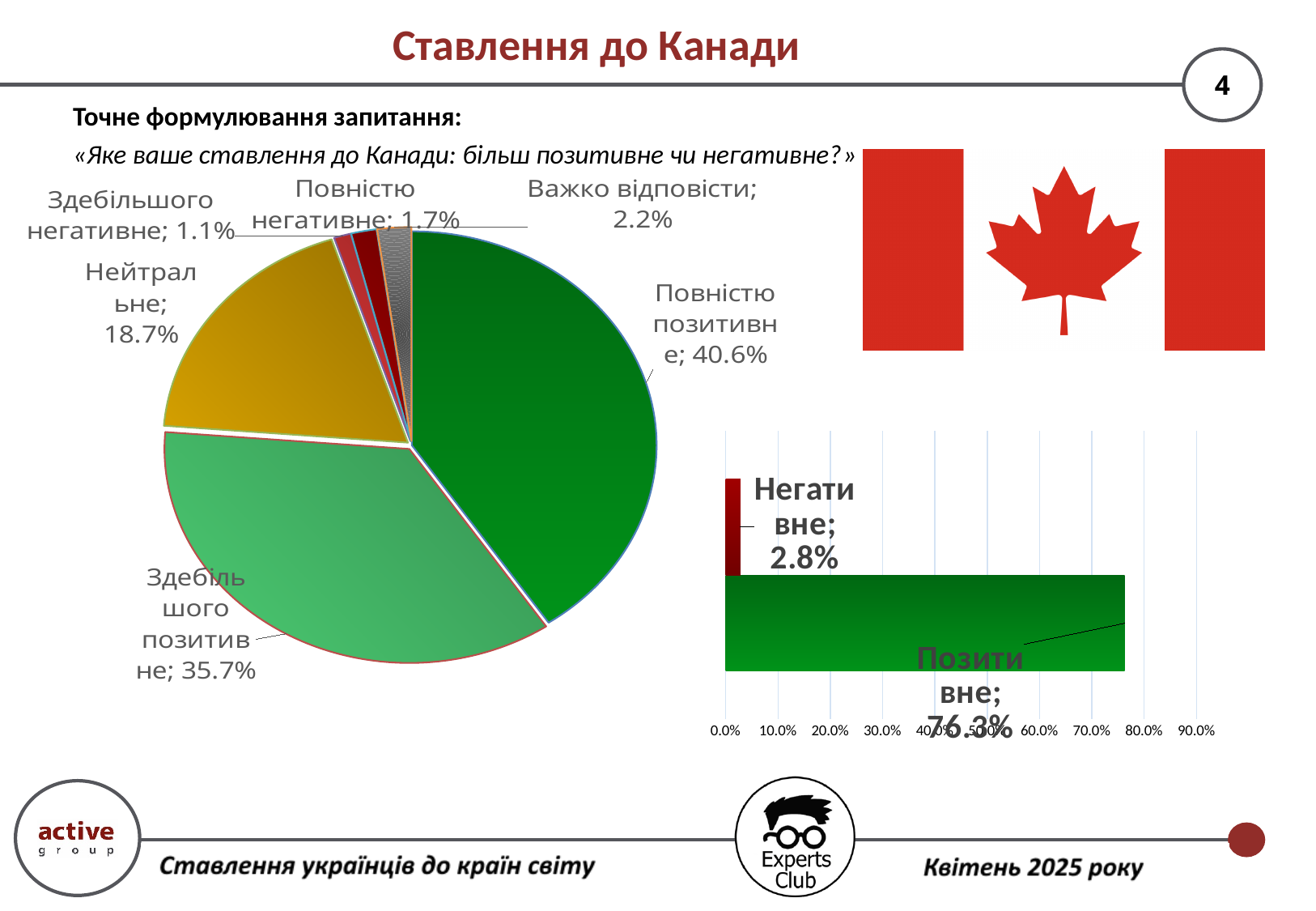
What type of chart is shown on the right side of the slide? Bar chart How many slices does the pie chart on the left have? 6 In the pie chart on the left, what is the difference between "Повністю позитивне" and "Здебільшого позитивне"? 4.9% In the bar chart on the right, what is the value for "Позитивне"? 76.3% In the bar chart on the right, what is the value for "Негативне"? 2.8% In the pie chart on the left, what is the value for "Важко відповісти"? 2.2% In the pie chart on the left, which category has the largest share? Повністю позитивне In the bar chart on the right, what is the difference between "Позитивне" and "Негативне"? 73.5% In the pie chart on the left, what is the value for "Повністю позитивне"? 40.6% In the pie chart on the left, what is the value for "Нейтральне"? 18.7% In the pie chart on the left, which category has the smallest share? Здебільшого негативне In the pie chart on the left, which is larger: "Повністю негативне" or "Здебільшого негативне"? Повністю негативне